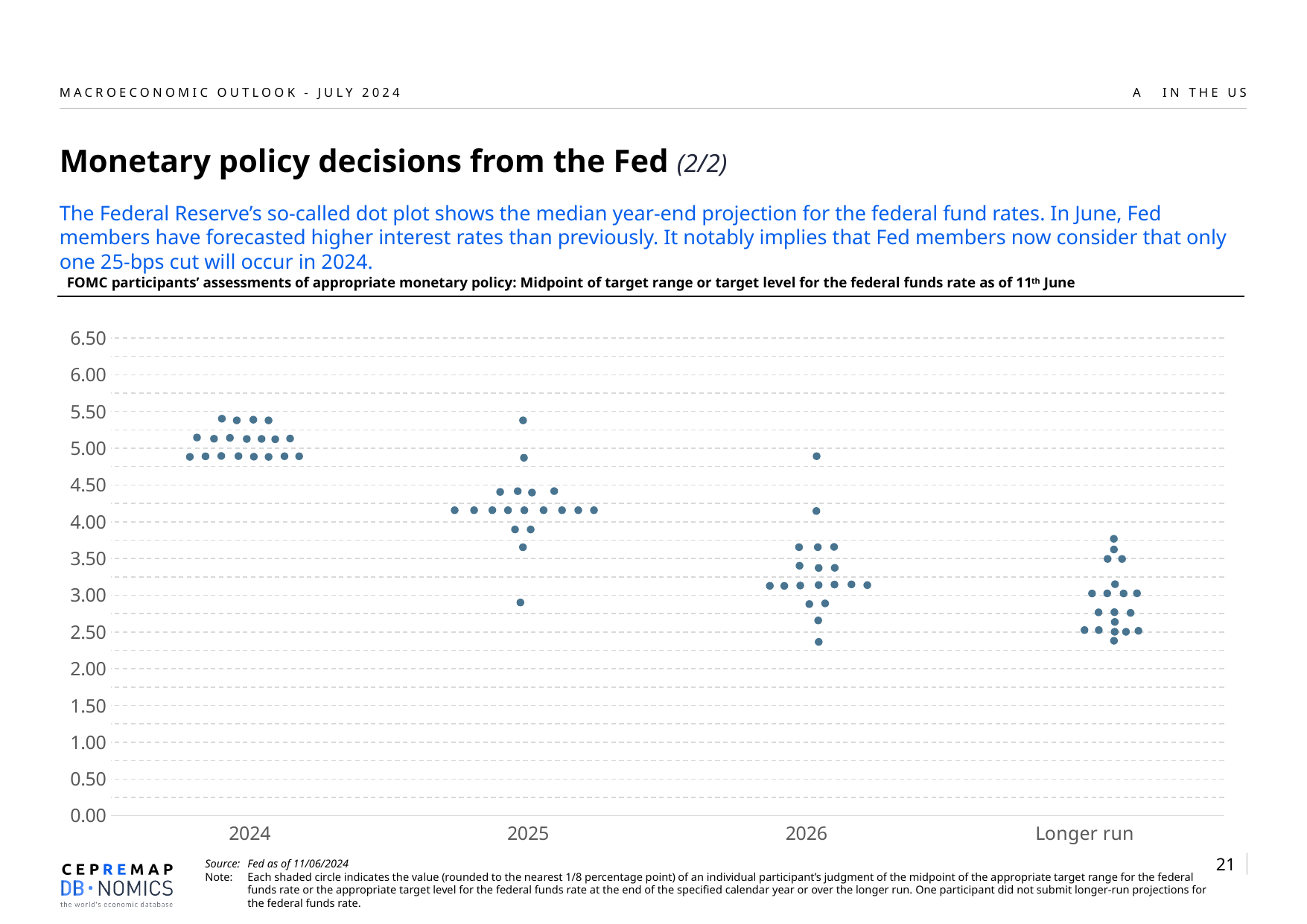
Is the highest dot for Longer run greater or less than 4.00? less What are the categories on the x axis? 2024, 2025, 2026, Longer run How many categories are shown on the x axis? 4 Is the lowest dot for 2025 greater or less than 3.50? less Is the lowest dot for 2024 greater or less than 4.50? greater Which has a higher top dot, 2024 or 2026? 2024 Do the dots generally rise or fall moving from 2024 to Longer run? fall What kind of chart is shown on the slide? Dot plot (scatter chart)